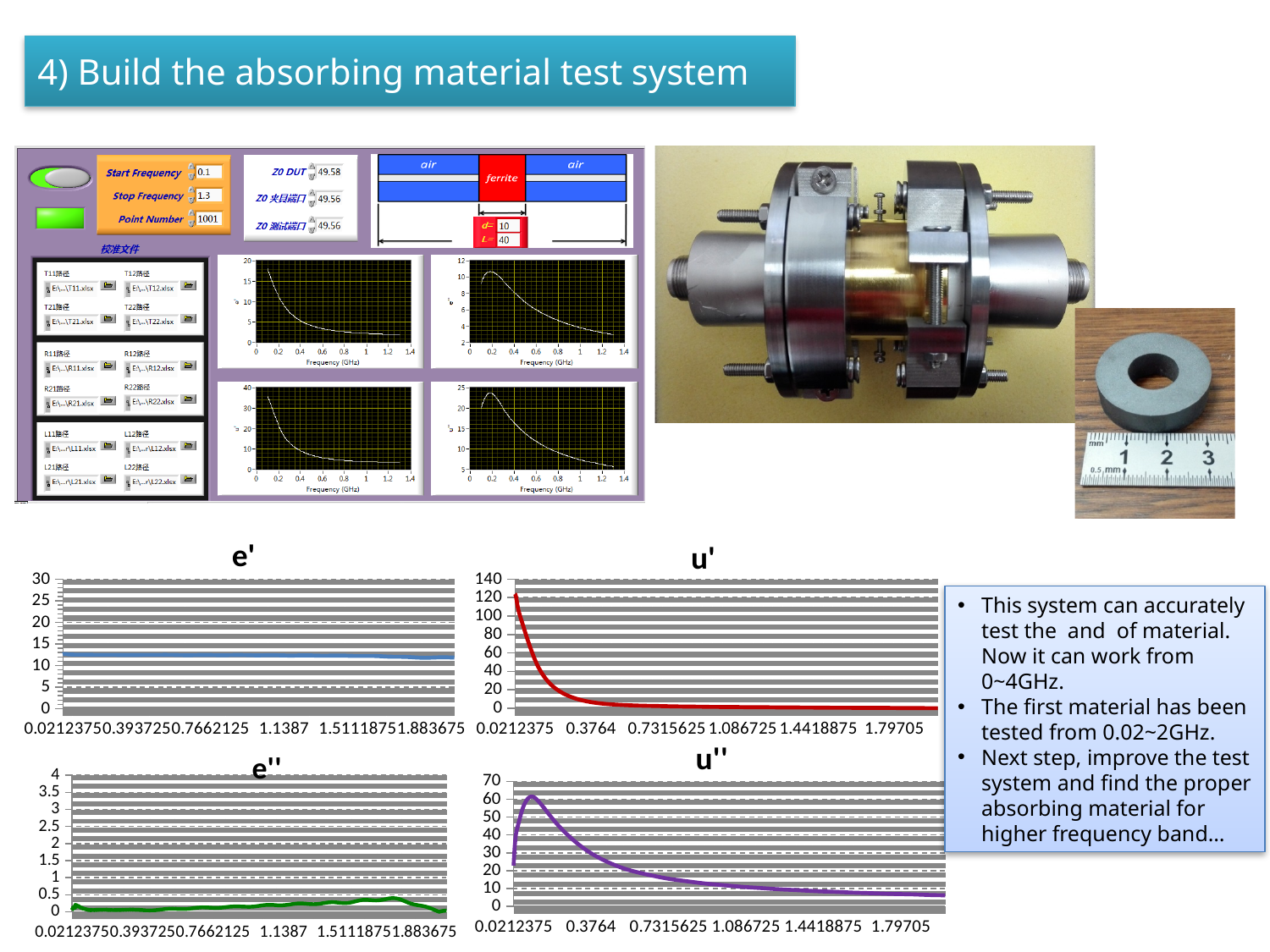
What kind of chart is the u' chart? line chart In the u'' chart, which is larger: the value at 0.3764 or the value at 1.79705? 0.3764 In the u'' chart, is the value at 1.79705 greater or less than 20? less In the e'' chart, is the highest plotted value greater or less than 1? less In the u' chart, is the value at the leftmost point (0.0212375) greater or less than 80? greater What is the highest value shown on the y axis of the u' chart? 140 What colour is the line in the u'' chart? purple In the u' chart, do the values rise or fall as frequency increases along the x axis? fall How many x-axis tick labels are shown on the u' chart? 6